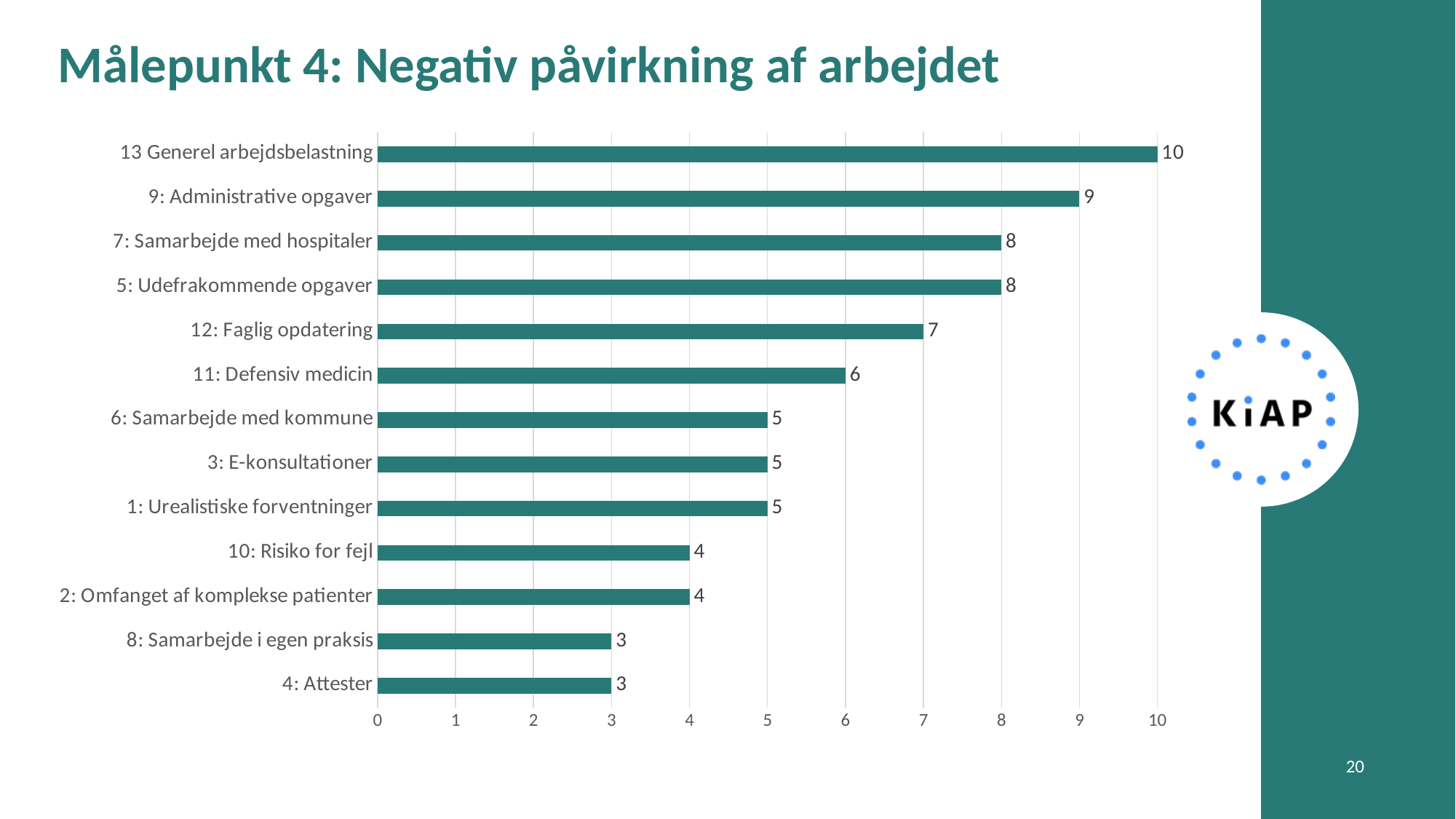
Which is larger, the value for "7: Samarbejde med hospitaler" or the value for "6: Samarbejde med kommune"? 7: Samarbejde med hospitaler Which category has the highest value? 13 Generel arbejdsbelastning How many categories are shown in the chart? 13 What kind of chart is shown on the slide? bar chart What is the difference between the values for "9: Administrative opgaver" and "10: Risiko for fejl"? 5 Is the value for "12: Faglig opdatering" greater or less than 5? greater What is the value for "11: Defensiv medicin"? 6 What is the title of the slide? Målepunkt 4: Negativ påvirkning af arbejdet What is the highest value shown on the x axis? 10 What is the value for "13 Generel arbejdsbelastning"? 10 What is the value for "12: Faglig opdatering"? 7 What is the value for "9: Administrative opgaver"? 9